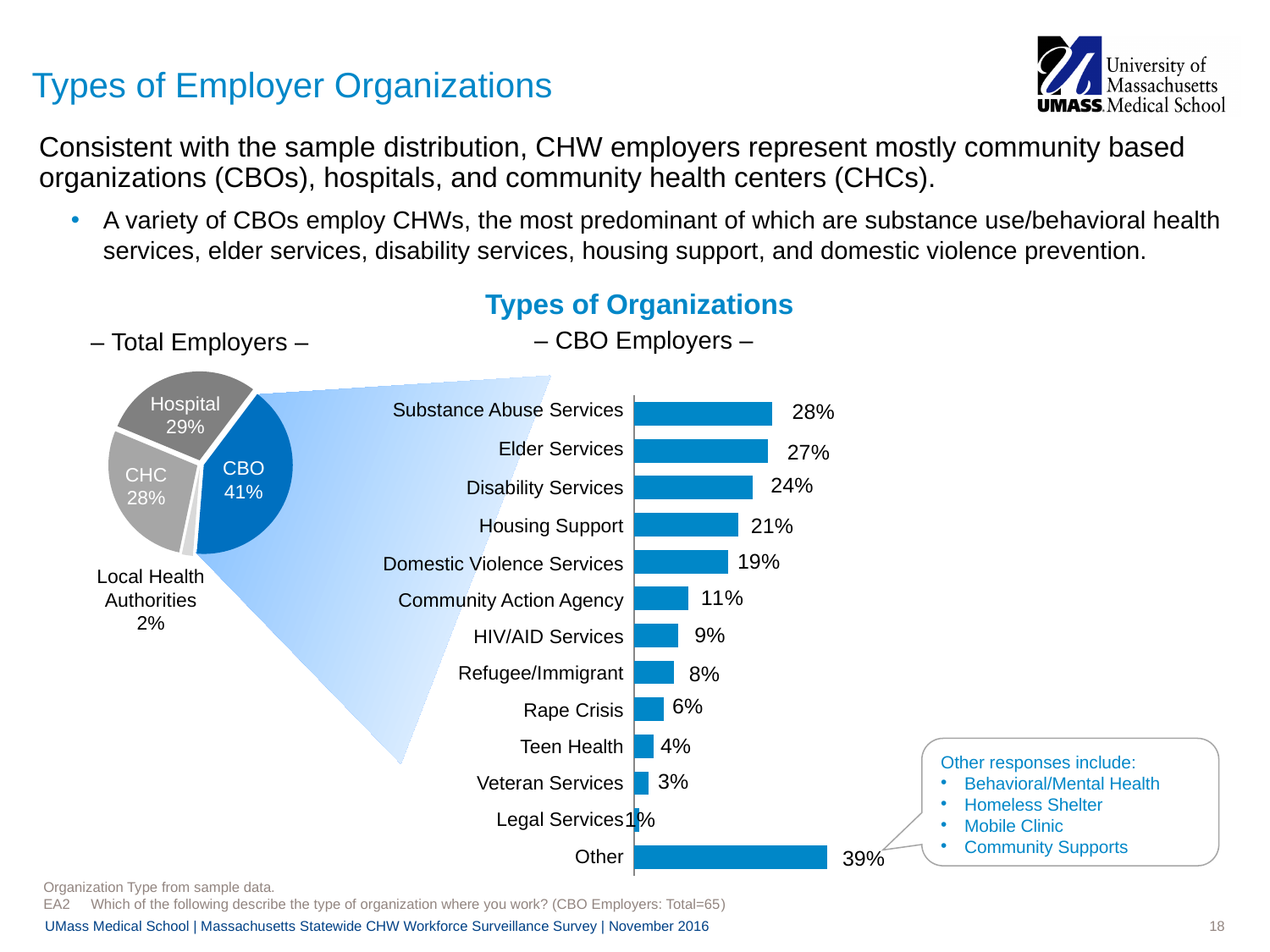
In the Total Employers pie chart, which category has the largest share? CBO In the CBO Employers bar chart, what is the value for Housing Support? 21% In the CBO Employers bar chart, what is the value for Elder Services? 27% In the Total Employers pie chart, what percentage is shown for Hospital? 29% In the CBO Employers bar chart, which is larger: Disability Services or Community Action Agency? Disability Services What type of chart is used for the CBO Employers data? Bar chart In the CBO Employers bar chart, which category has the highest value? Other In the Total Employers pie chart, which category has the smallest share? Local Health Authorities In the Total Employers pie chart, what share of employers are CBOs? 41% In the Total Employers pie chart, how many categories are shown? 4 In the CBO Employers bar chart, which category has the lowest value? Legal Services In the CBO Employers bar chart, what is the difference between Substance Abuse Services and Domestic Violence Services? 9%